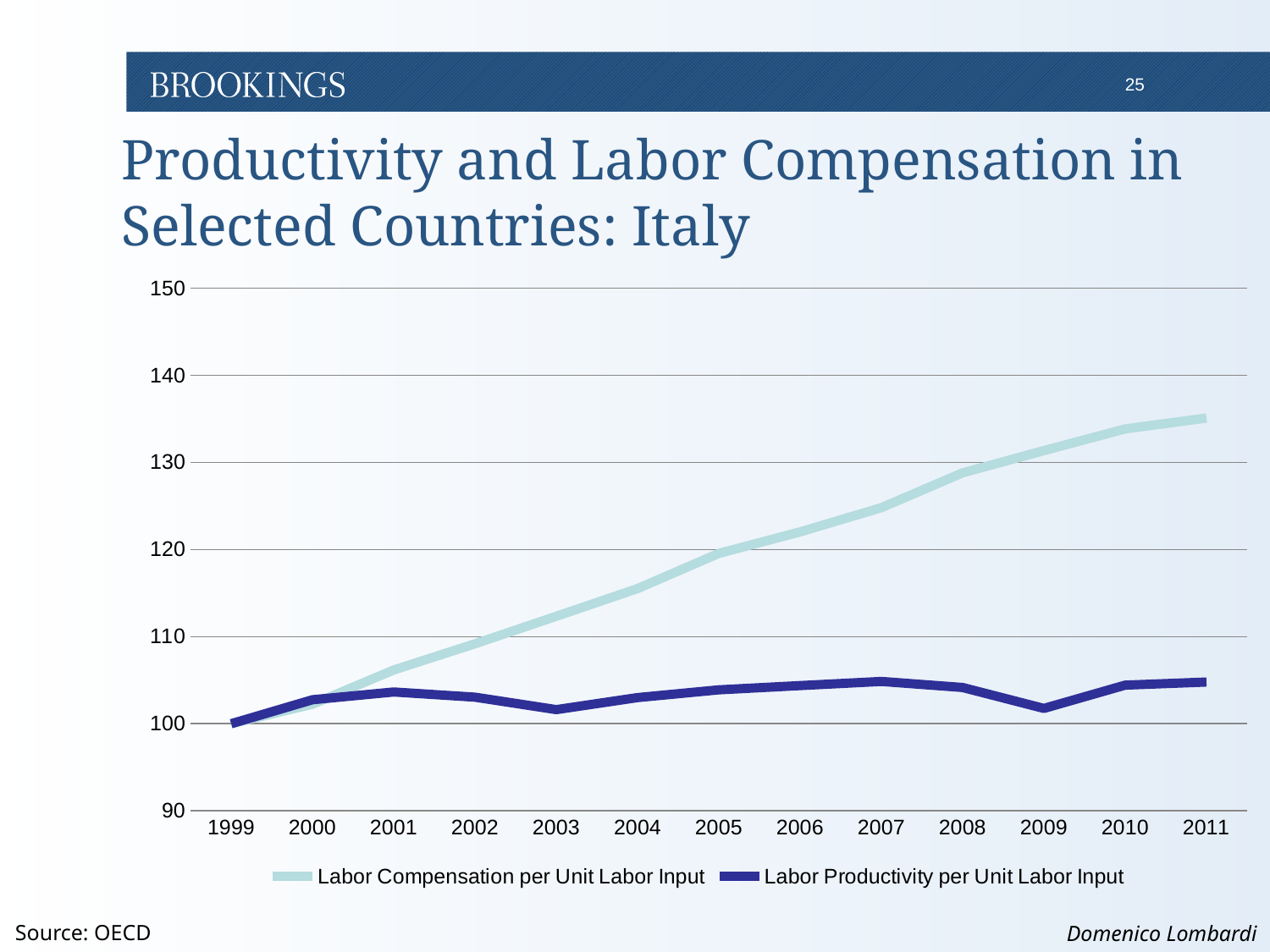
Is the value of Labor Compensation per Unit Labor Input in 2011 greater or less than 130? greater Does Labor Compensation per Unit Labor Input rise or fall from 1999 to 2011? rise What is the title of the chart on the slide? Productivity and Labor Compensation in Selected Countries: Italy What kind of chart is shown on the slide? line chart In 2008, which series has the higher value: Labor Compensation per Unit Labor Input or Labor Productivity per Unit Labor Input? Labor Compensation per Unit Labor Input In which year is Labor Compensation per Unit Labor Input at its lowest value? 1999 How many years are shown on the x axis? 13 Is the value of Labor Compensation per Unit Labor Input in 2005 greater or less than 110? greater How many series does the legend list? 2 Is the value of Labor Productivity per Unit Labor Input in 2011 greater or less than 110? less In which year does Labor Compensation per Unit Labor Input reach its highest value? 2011 What is the source cited for the chart? OECD